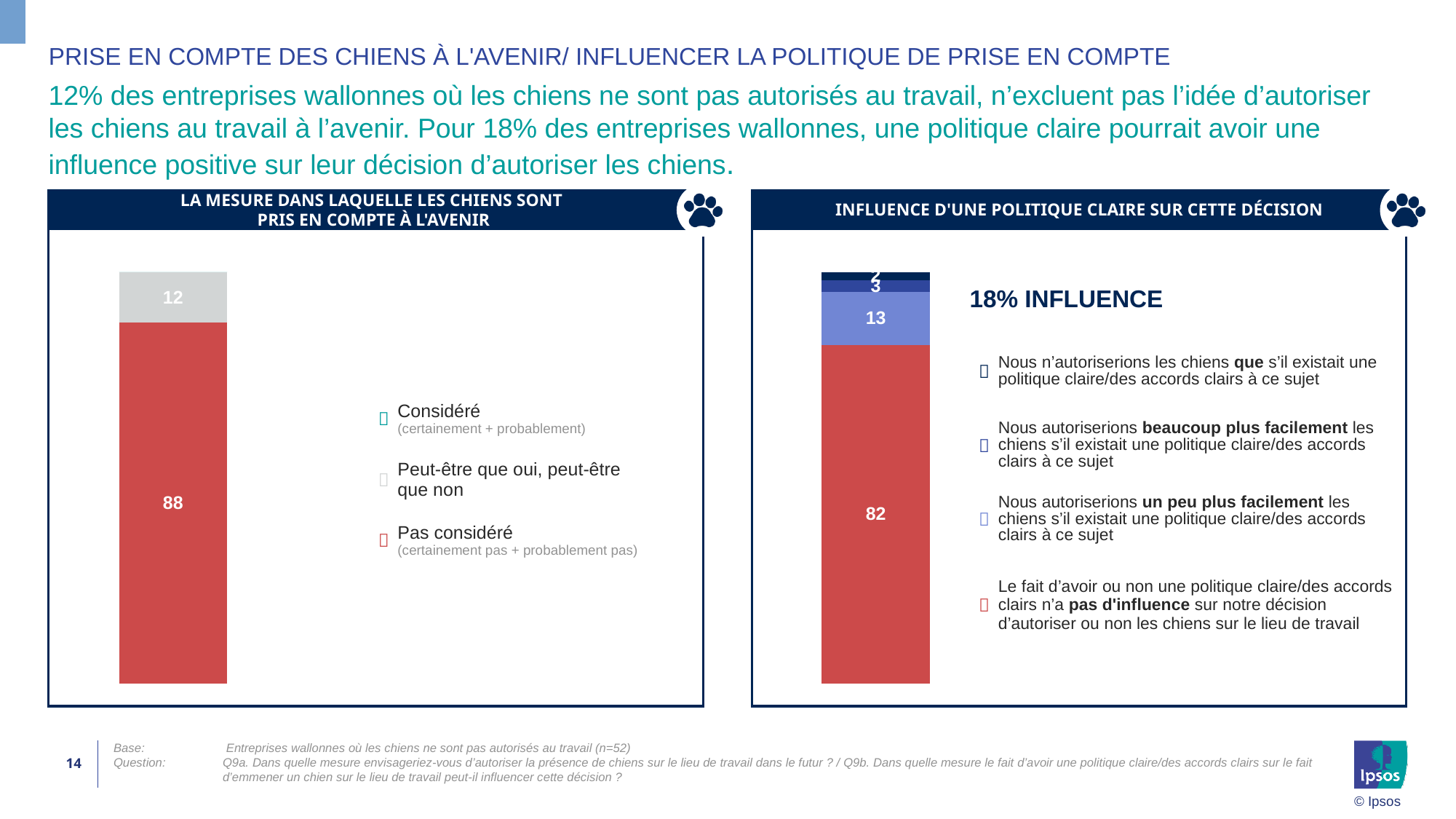
On the right chart, which is larger: the 'pas d'influence' segment or the 'un peu plus facilement' segment? pas d'influence On the left chart, what is the total of the stacked bar? 100 On the right chart, what percentage is highlighted as 'INFLUENCE' next to the bar? 18% On the right chart, what is the difference between the 'pas d'influence' value and the 'un peu plus facilement' value? 69 What type of chart is used on the right side of the slide? Stacked bar chart On the left chart, what is the difference between the 'Pas considéré' and 'Peut-être que oui, peut-être que non' values? 76 On the right chart 'Influence d'une politique claire sur cette décision', what is the value for 'pas d'influence'? 82 On the left chart 'La mesure dans laquelle les chiens sont pris en compte à l'avenir', what is the value for 'Peut-être que oui, peut-être que non'? 12 On the left chart, which category has the largest segment? Pas considéré On the right chart, which category has the largest segment? Le fait d'avoir ou non une politique claire n'a pas d'influence On the left chart 'La mesure dans laquelle les chiens sont pris en compte à l'avenir', what is the value for 'Pas considéré'? 88 On the right chart 'Influence d'une politique claire sur cette décision', what is the value for 'Nous autoriserions un peu plus facilement les chiens'? 13